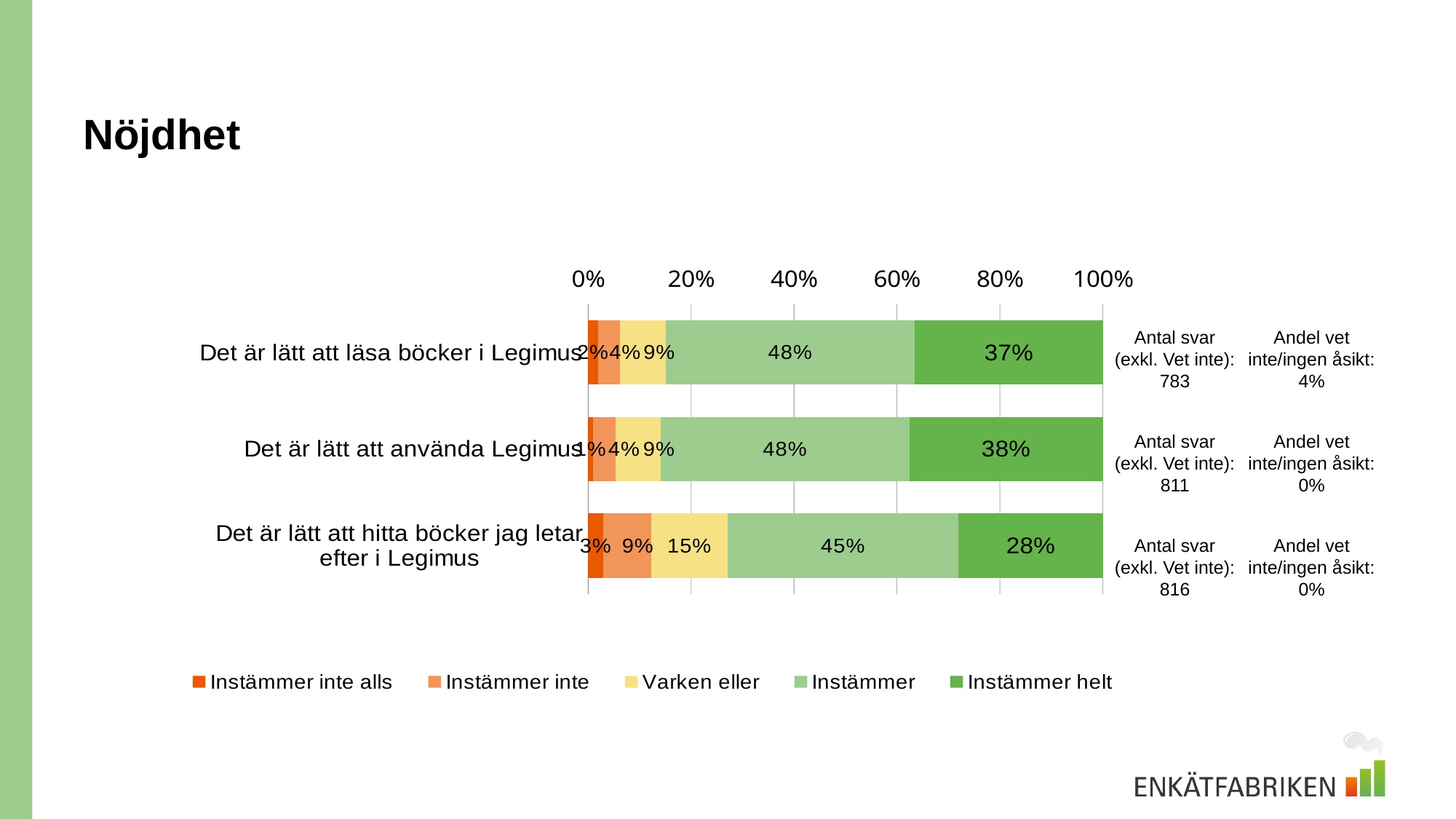
What is the 'Instämmer' value for 'Det är lätt att hitta böcker jag letar efter i Legimus'? 45% Which statement has the highest 'Instämmer helt' share? Det är lätt att använda Legimus How many series does the legend list? 5 What kind of chart is shown on the slide? Stacked bar chart What is the 'Instämmer inte alls' value for 'Det är lätt att hitta böcker jag letar efter i Legimus'? 3% What is the 'Instämmer helt' value for 'Det är lätt att använda Legimus'? 38% What is the title of the slide containing the chart? Nöjdhet Which is larger: the 'Varken eller' value for 'Det är lätt att läsa böcker i Legimus' or for 'Det är lätt att hitta böcker jag letar efter i Legimus'? Det är lätt att hitta böcker jag letar efter i Legimus What is the 'Varken eller' value for 'Det är lätt att hitta böcker jag letar efter i Legimus'? 15% What is the difference between the 'Instämmer helt' values for 'Det är lätt att använda Legimus' and 'Det är lätt att hitta böcker jag letar efter i Legimus'? 10% Which statement has the lowest 'Instämmer helt' share? Det är lätt att hitta böcker jag letar efter i Legimus How many categories (statements) are plotted in the chart? 3